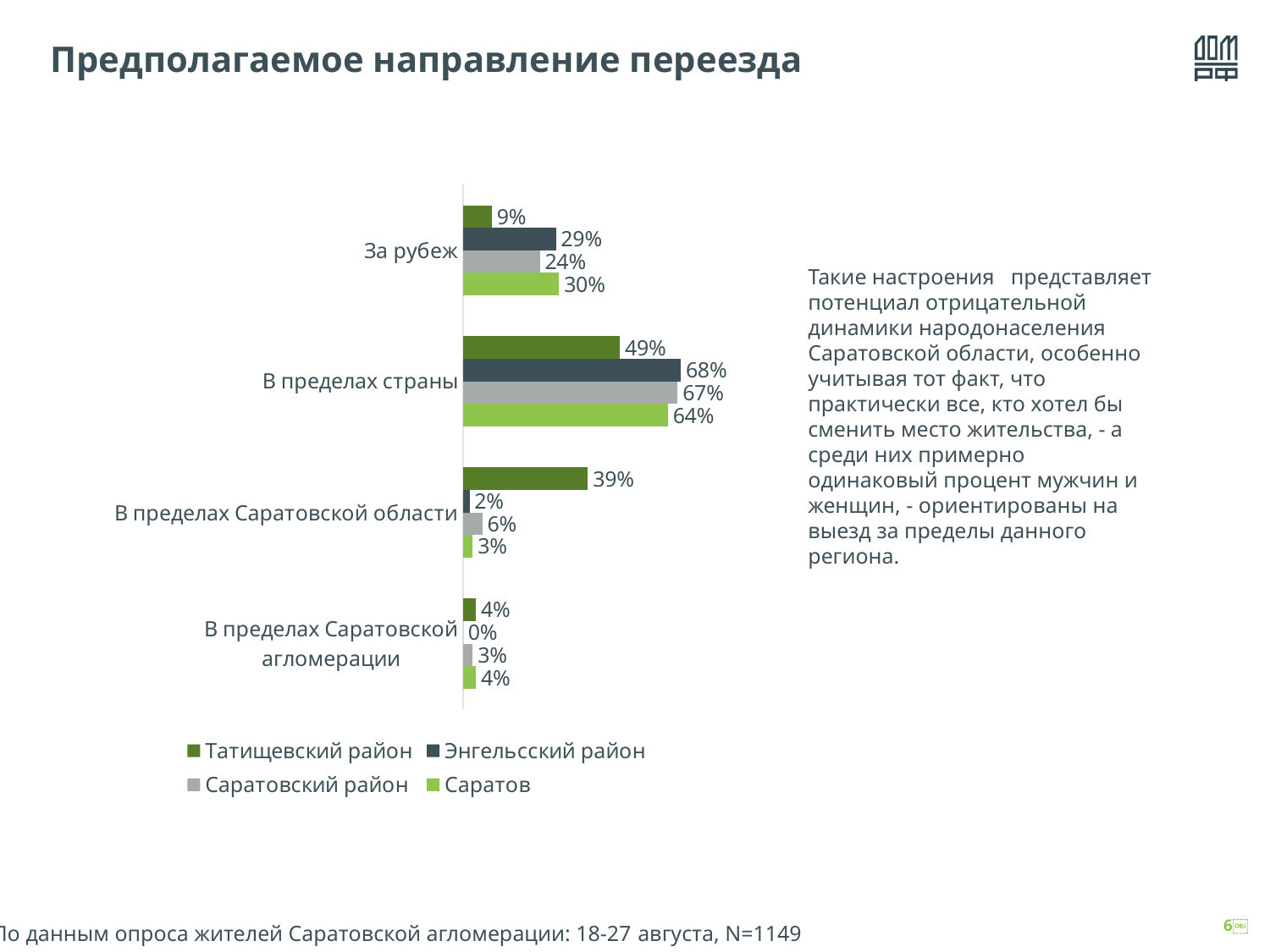
What is the value for Энгельсский район in the category "В пределах страны"? 68% Which series has the highest value in the category "В пределах страны"? Энгельсский район What is the difference between Энгельсский район and Татищевский район in the category "В пределах страны"? 19% How many categories are shown on the chart? 4 Which series has the lowest value in the category "За рубеж"? Татищевский район What kind of chart is shown on the slide? Bar chart In the category "В пределах Саратовской области", which is larger: Саратовский район or Саратов? Саратовский район What is the value for Татищевский район in the category "В пределах Саратовской области"? 39% How many series does the legend list? 4 What is the title of the chart on the slide? Предполагаемое направление переезда What is the value for Саратов in the category "За рубеж"? 30% What is the value for Энгельсский район in the category "В пределах Саратовской агломерации"? 0%